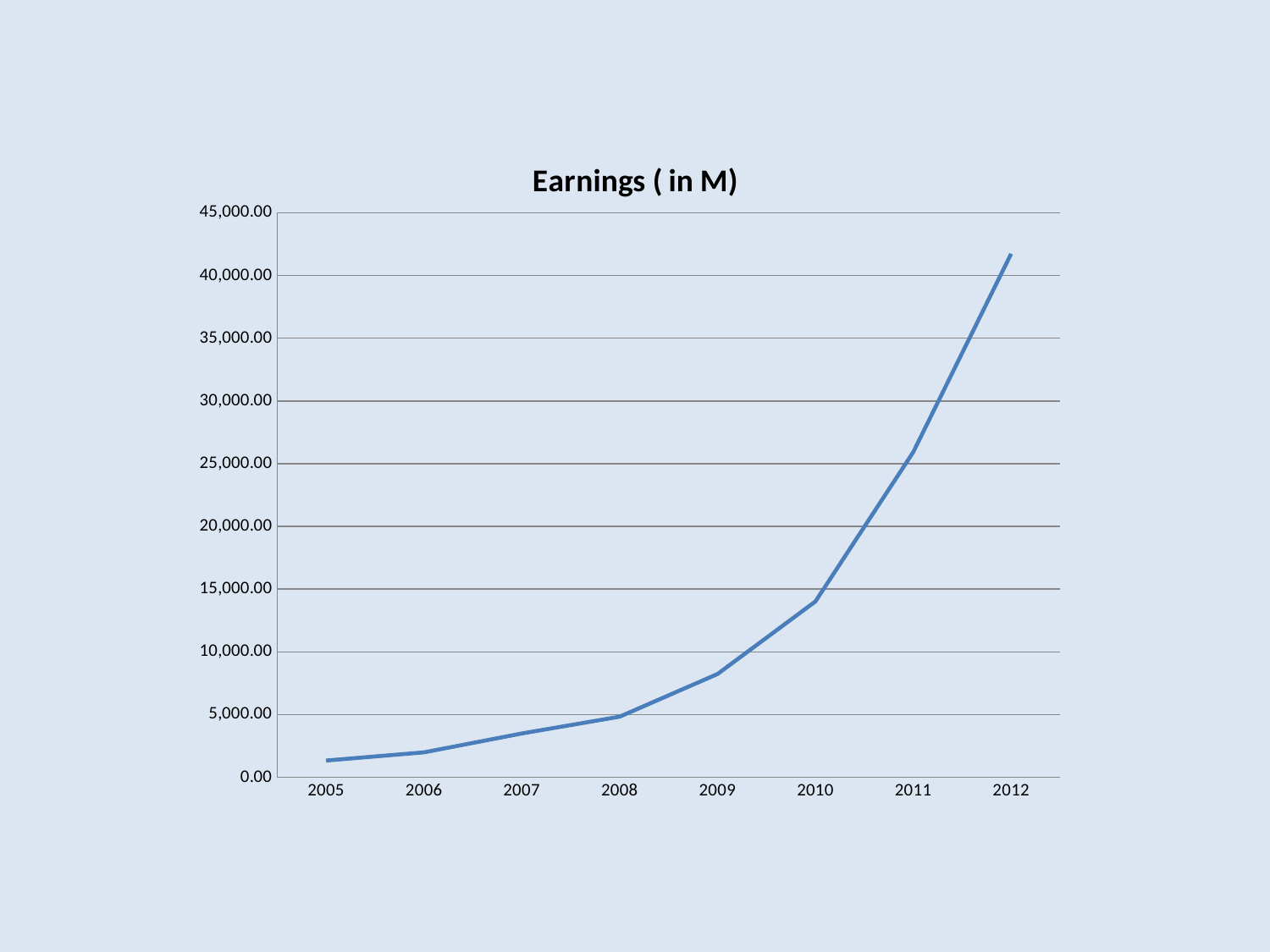
Is the value for 2005 greater or less than 5,000.00? less Is the value for 2012 greater or less than 40,000.00? greater Is the value for 2011 greater or less than 30,000.00? less What kind of chart is shown on the slide? line chart What is the title of the chart? Earnings ( in M) Which year has higher earnings, 2009 or 2011? 2011 How many years are plotted on the x axis? 8 Which year has the highest earnings? 2012 Which year has the lowest earnings? 2005 Do earnings rise or fall from 2005 to 2012? rise